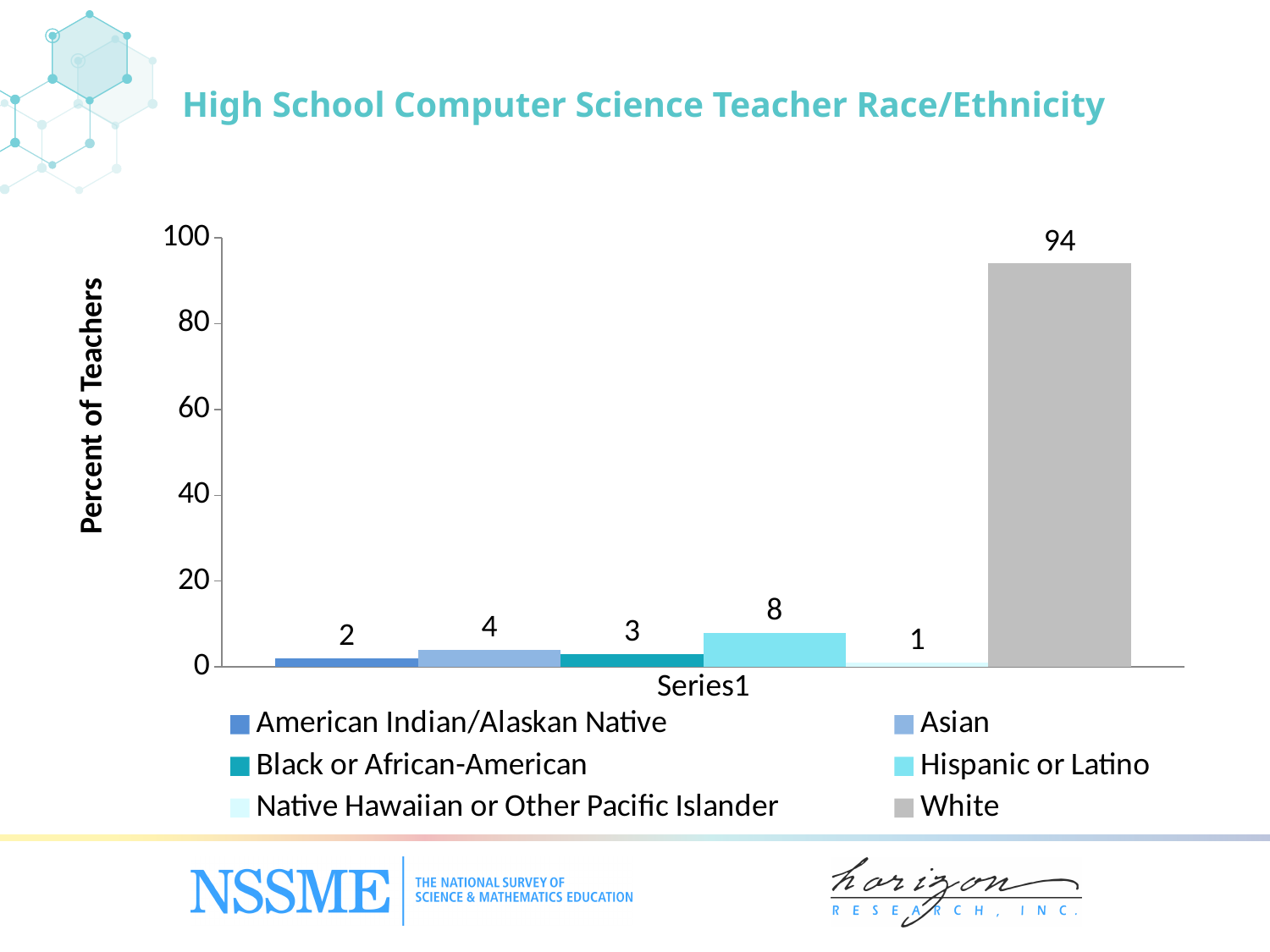
What is the difference between the values for White and Hispanic or Latino? 86 How many series does the legend list? 6 What is the value for White? 94 Is the value for White greater or less than 80? greater What is the value for Native Hawaiian or Other Pacific Islander? 1 What is the value for Asian? 4 What is the label of the y axis? Percent of Teachers Which group has the highest value? White What kind of chart is shown? bar chart What is the value for Hispanic or Latino? 8 Which is larger, the value for Asian or the value for Black or African-American? Asian Which group has the lowest value? Native Hawaiian or Other Pacific Islander